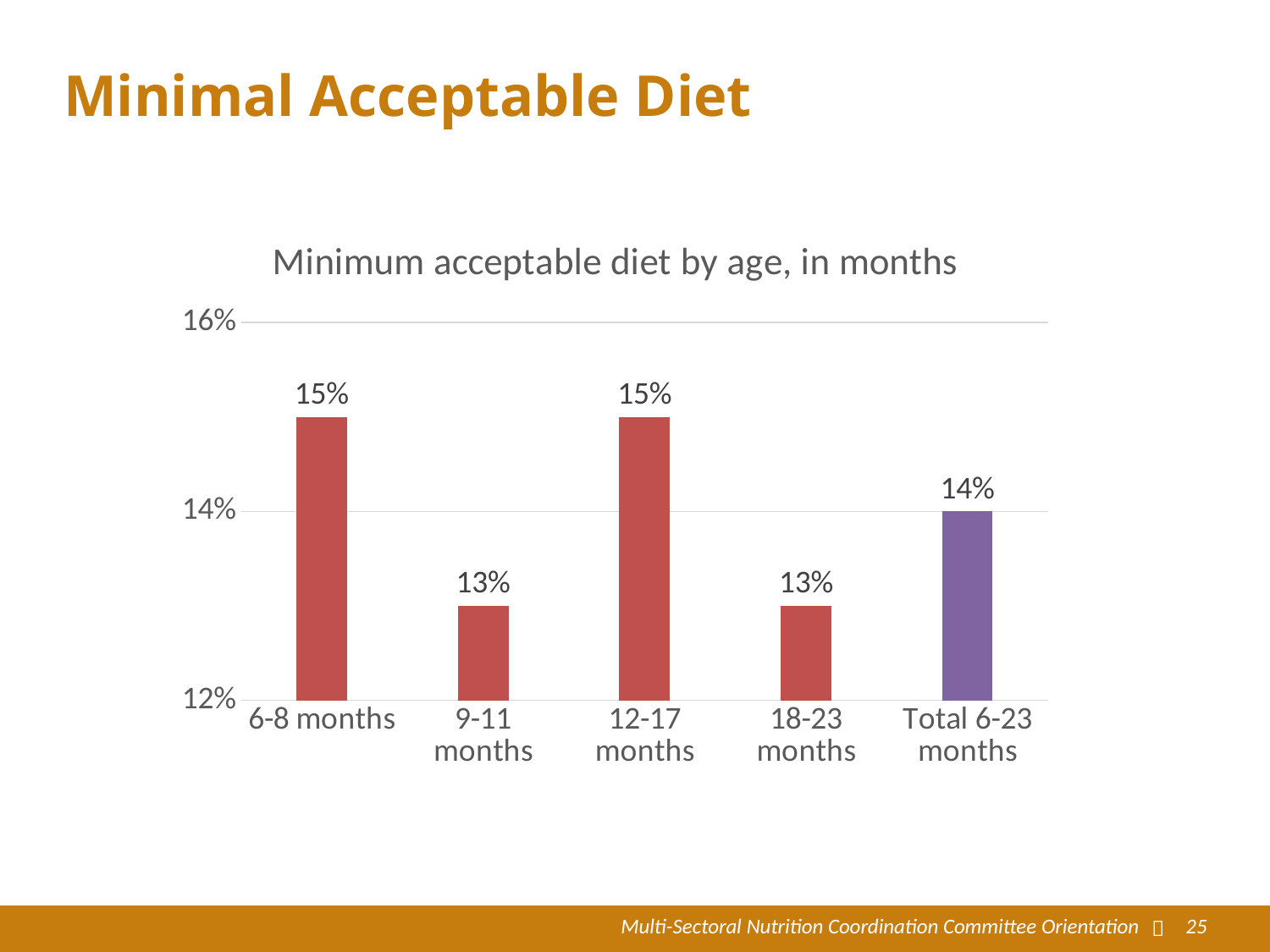
Which is larger, the value for 12-17 months or the value for 18-23 months? 12-17 months What is the value for 18-23 months? 13% Is the value for Total 6-23 months greater or less than 16%? less What is the value for 9-11 months? 13% Which bar is shown in a different colour from the others? Total 6-23 months What kind of chart is shown on the slide? bar chart What is the value for 12-17 months? 15% What is the value for Total 6-23 months? 14% What is the difference between the values for 6-8 months and 9-11 months? 2% What is the title of the chart? Minimum acceptable diet by age, in months How many categories are shown on the x axis? 5 What is the value for 6-8 months? 15%